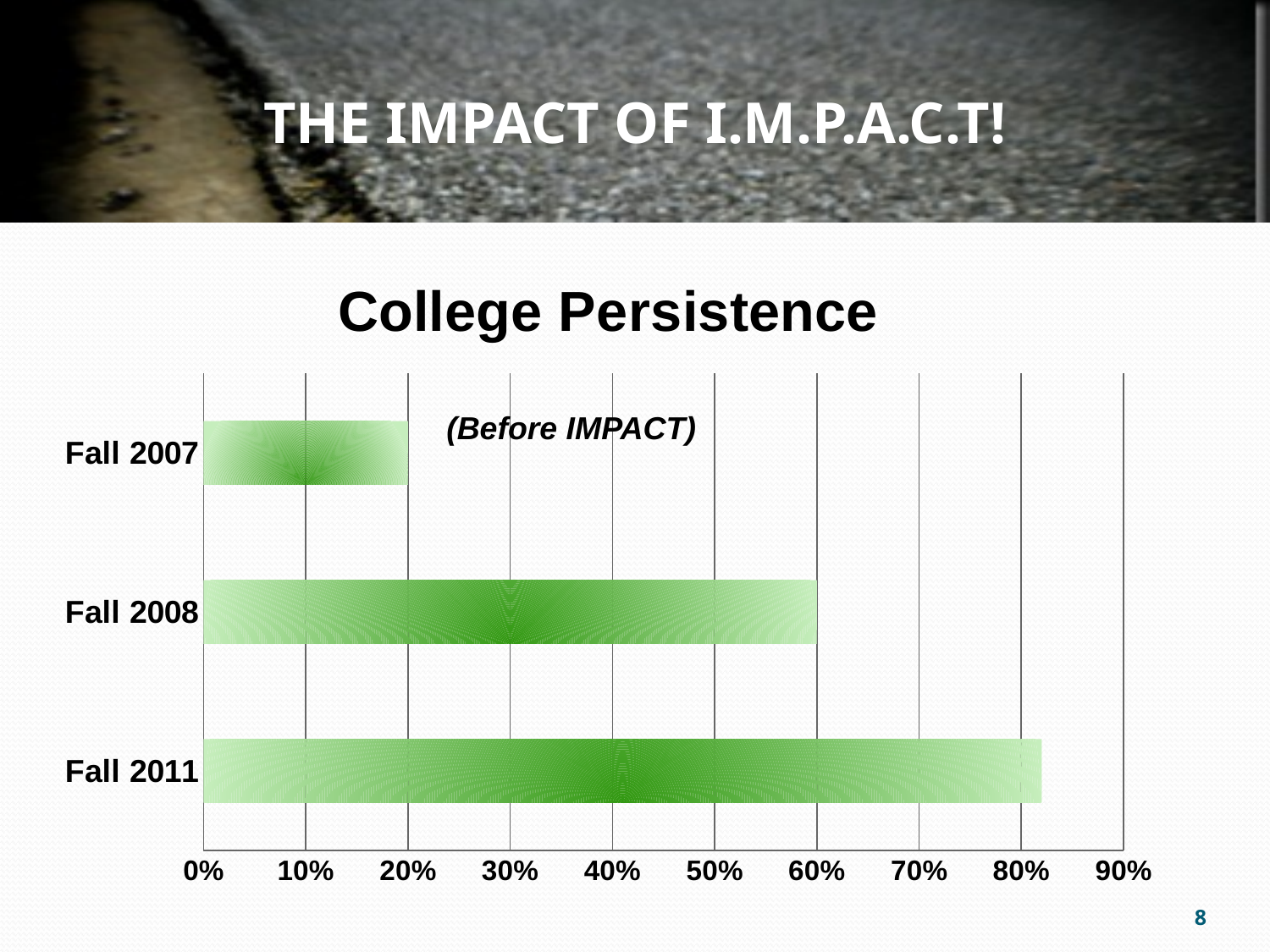
Which is larger, the value for Fall 2008 or the value for Fall 2007? Fall 2008 What type of chart is shown on the slide? bar chart How many categories are plotted in the College Persistence chart? 3 Which category is annotated with the label '(Before IMPACT)'? Fall 2007 What is the college persistence value for Fall 2008? 60% What is the title of the chart? College Persistence Which category has the lowest college persistence value? Fall 2007 Is the value for Fall 2011 greater or less than 80%? greater Which category has the highest college persistence value? Fall 2011 What is the difference between the Fall 2008 and Fall 2007 values? 40% What is the college persistence value for Fall 2007? 20% Is the value for Fall 2011 greater or less than 90%? less